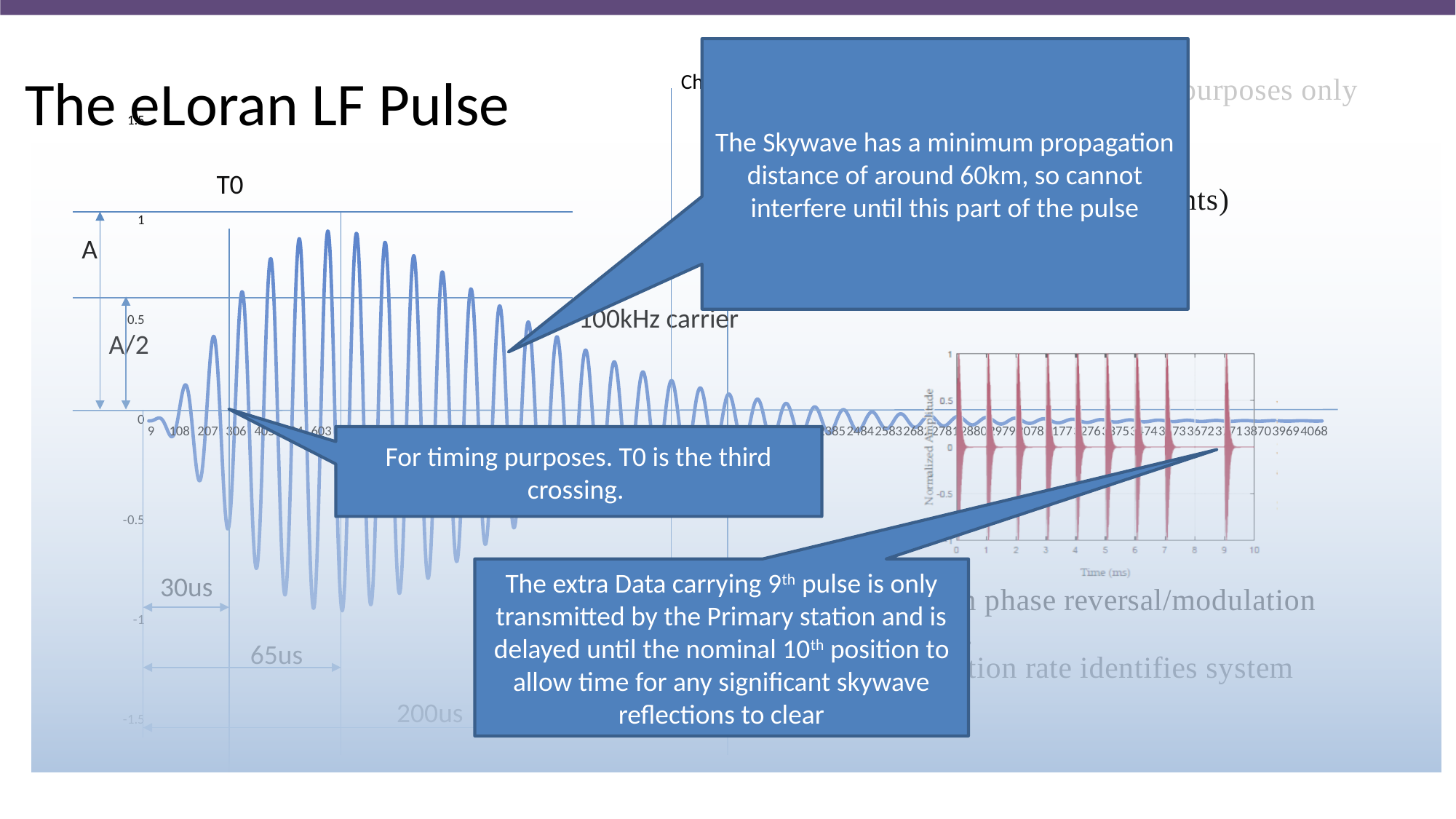
According to the annotation on the large waveform chart, which zero crossing is T0? the third crossing In the inset chart at the right, is the peak of the last pulse (near 9 ms) greater or less than 0.5? greater In the inset chart at the right, what is the label of the x axis? Time (ms) On the large waveform chart, is the value at the first x-axis label (9) greater or less than 0.5? less What carrier frequency is labelled on the large waveform chart? 100kHz carrier On the large waveform chart, is the lowest trough of the pulse greater or less than -0.5? less On the large waveform chart, does the pulse amplitude rise or fall along the x axis after the peak near x = 603? fall What kind of chart is the large waveform chart on the slide? line chart How many pulses are shown in the inset chart of Normalized Amplitude versus Time (ms)? 9